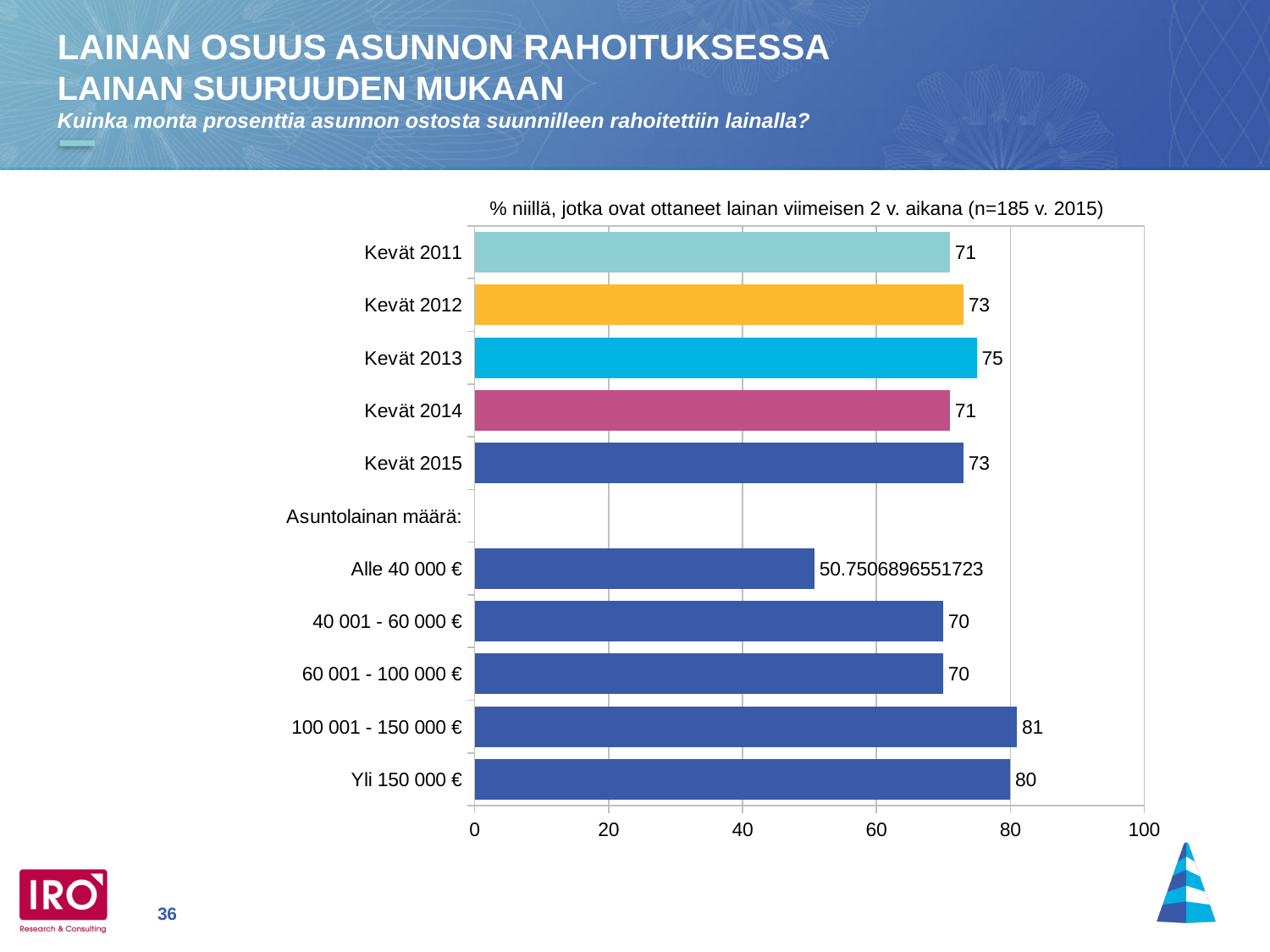
Which category has the lowest value? Alle 40 000 € What is the value for Kevät 2015? 73 Which category has the highest value? 100 001 - 150 000 € What kind of chart is shown on the slide? bar chart What is the value for Kevät 2013? 75 What is the value for Yli 150 000 €? 80 What is the sample size stated in the text above the chart? n=185 v. 2015 What is the value for Alle 40 000 €? 50.7506896551723 Is the value for Alle 40 000 € greater or less than 60? less How many bars are plotted in the chart? 10 What is the difference between the values for Kevät 2013 and Kevät 2011? 4 Which is larger, the value for Kevät 2013 or the value for Kevät 2012? Kevät 2013